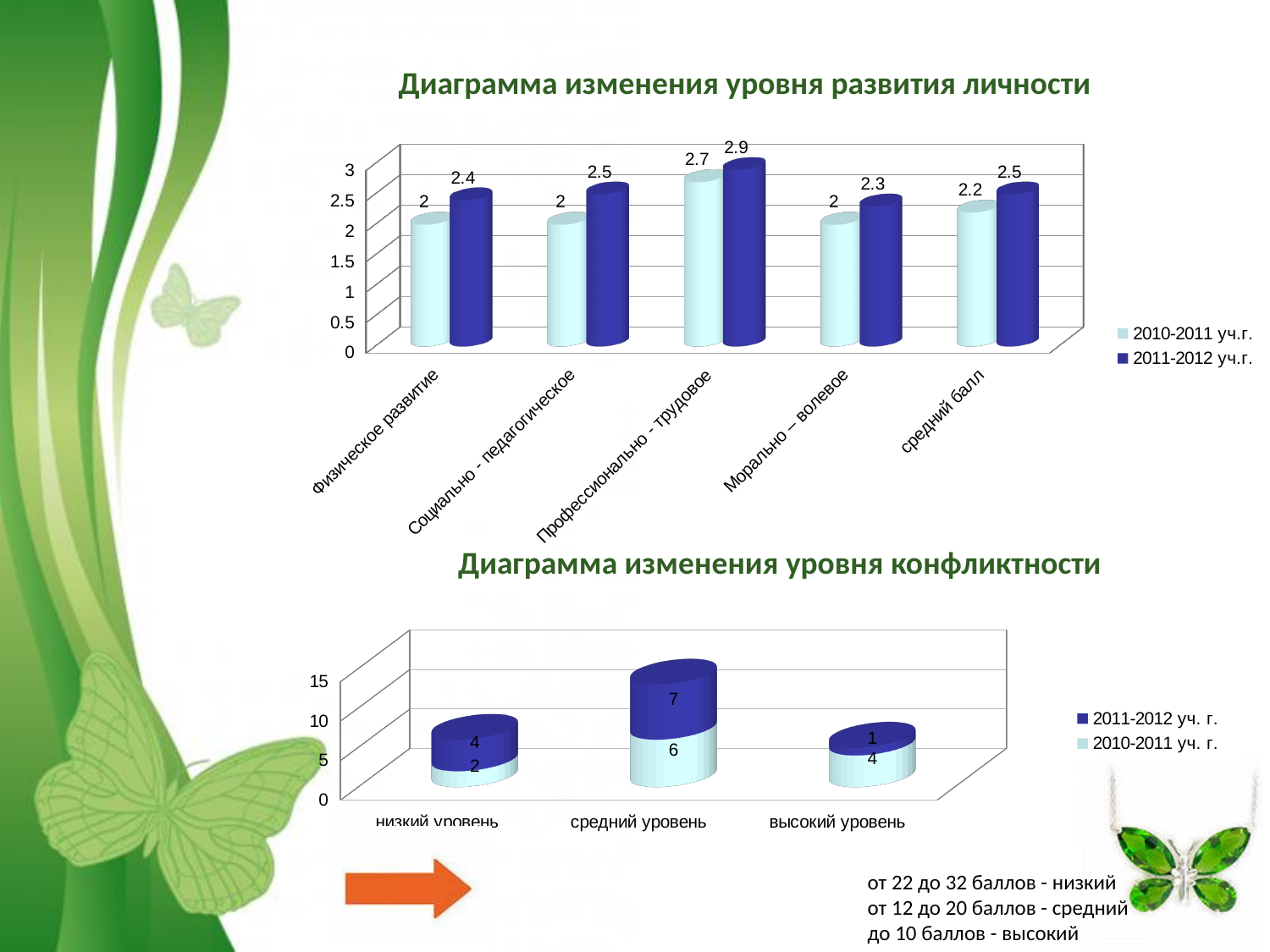
In the chart 'Диаграмма изменения уровня конфликтности', what is the value for 'высокий уровень' in the 2010-2011 уч. г. series? 4 In the chart 'Диаграмма изменения уровня развития личности', what is the value for 'средний балл' in the 2010-2011 уч.г. series? 2.2 In the chart 'Диаграмма изменения уровня конфликтности', which category has the lowest stacked total? высокий уровень In the chart 'Диаграмма изменения уровня развития личности', which is larger for 'Морально – волевое': the 2010-2011 уч.г. value or the 2011-2012 уч.г. value? 2011-2012 уч.г. In the chart 'Диаграмма изменения уровня развития личности', what is the difference between the 2011-2012 уч.г. and 2010-2011 уч.г. values for 'Физическое развитие'? 0.4 In the chart 'Диаграмма изменения уровня конфликтности', what is the value for 'средний уровень' in the 2011-2012 уч. г. series? 7 In the chart 'Диаграмма изменения уровня развития личности', what is the value for 'Профессионально - трудовое' in the 2011-2012 уч.г. series? 2.9 In the chart 'Диаграмма изменения уровня конфликтности', what is the total of the stacked bar for 'средний уровень'? 13 In the chart 'Диаграмма изменения уровня развития личности', which category has the highest value in the 2011-2012 уч.г. series? Профессионально - трудовое In the chart 'Диаграмма изменения уровня развития личности', how many series does the legend list? 2 In the chart 'Диаграмма изменения уровня развития личности', how many categories are shown on the x axis? 5 What kind of chart is 'Диаграмма изменения уровня конфликтности'? Stacked bar chart